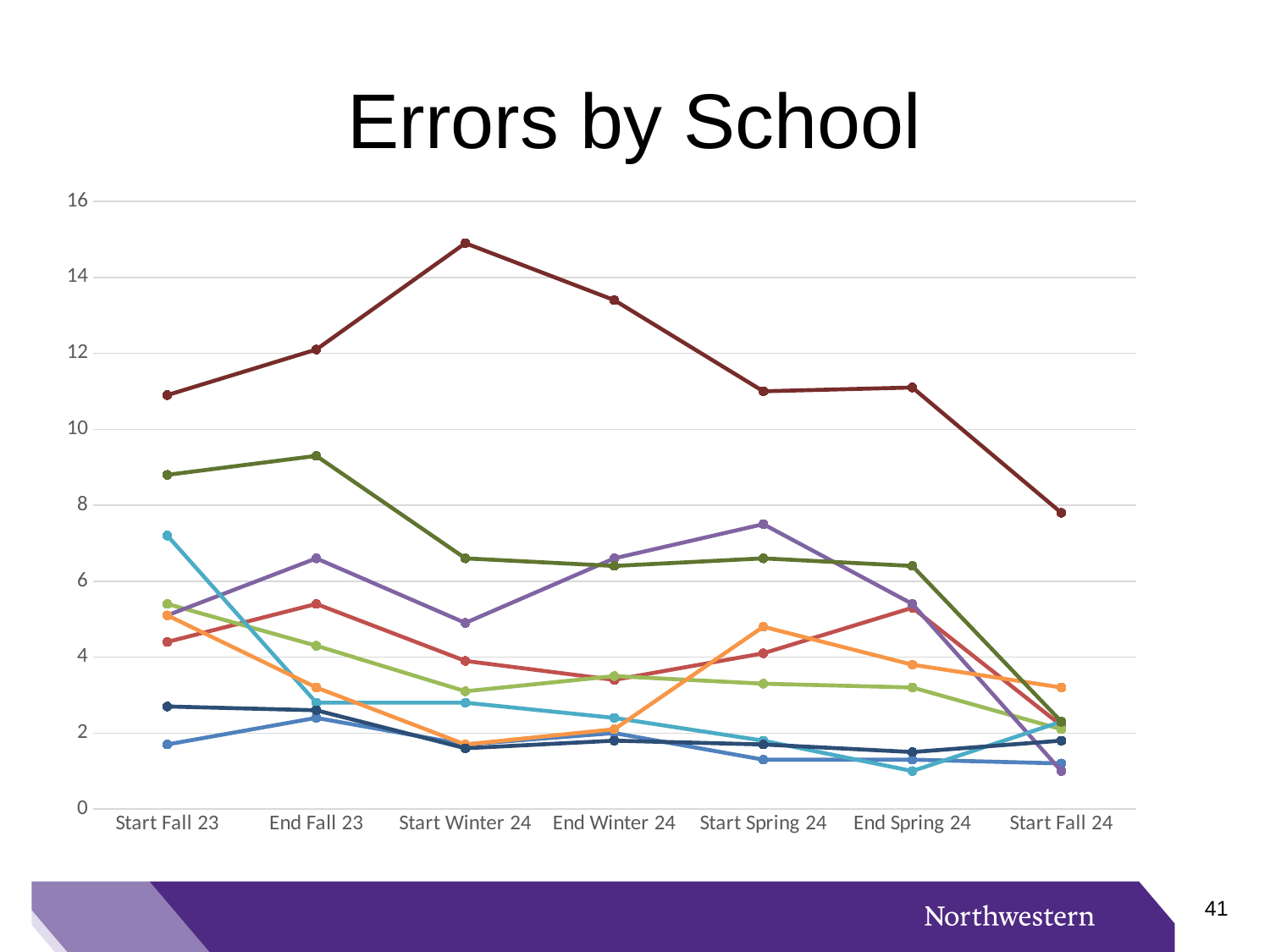
At which x-axis category does the topmost line reach its highest point? Start Winter 24 What is the maximum value shown on the y axis? 16 Is the value of the topmost line at Start Fall 23 greater or less than 10? greater Is the lowest value at Start Fall 23 greater or less than 2? less What is the title of the chart? Errors by School How many time points are shown along the x axis? 7 What kind of chart is shown on the slide? line chart Is the highest value at Start Fall 24 greater or less than the highest value at End Spring 24? less Is the value of the topmost line at Start Winter 24 greater or less than 14? greater What is the first category on the x axis? Start Fall 23 Does the topmost line rise or fall from Start Winter 24 to Start Fall 24? fall